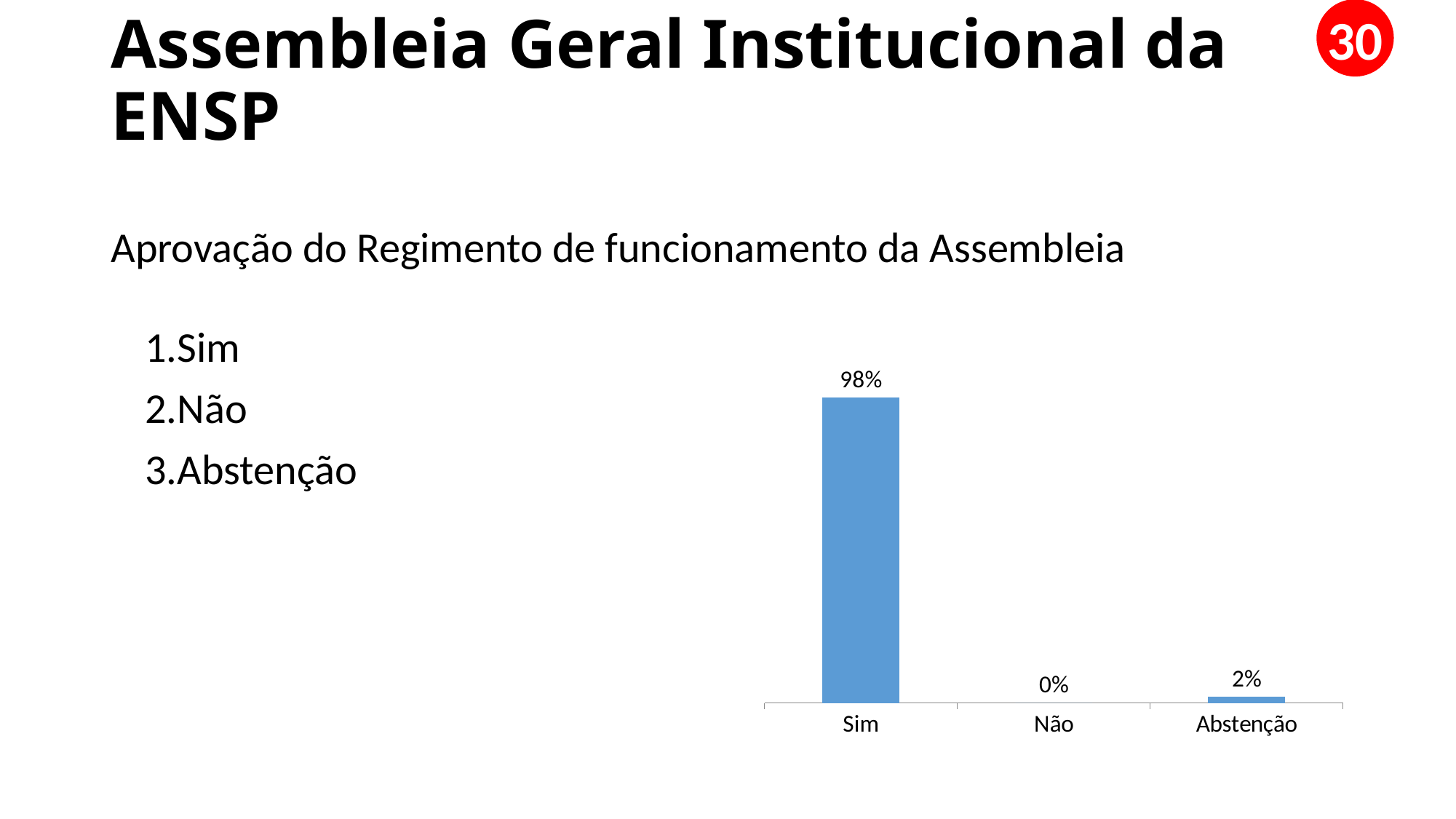
What is the difference between the values for Abstenção and Não? 2% What is the total of the three values shown in the chart? 100% Which is larger, the value for Abstenção or the value for Não? Abstenção Which category has the lowest value? Não What is the value for Sim? 98% What kind of chart is shown on the slide? Bar chart How many categories are shown on the x axis? 3 What is the difference between the values for Sim and Abstenção? 96% What is the value for Abstenção? 2% Which category has the highest value? Sim What is the value for Não? 0% What colour are the bars in the chart? Blue